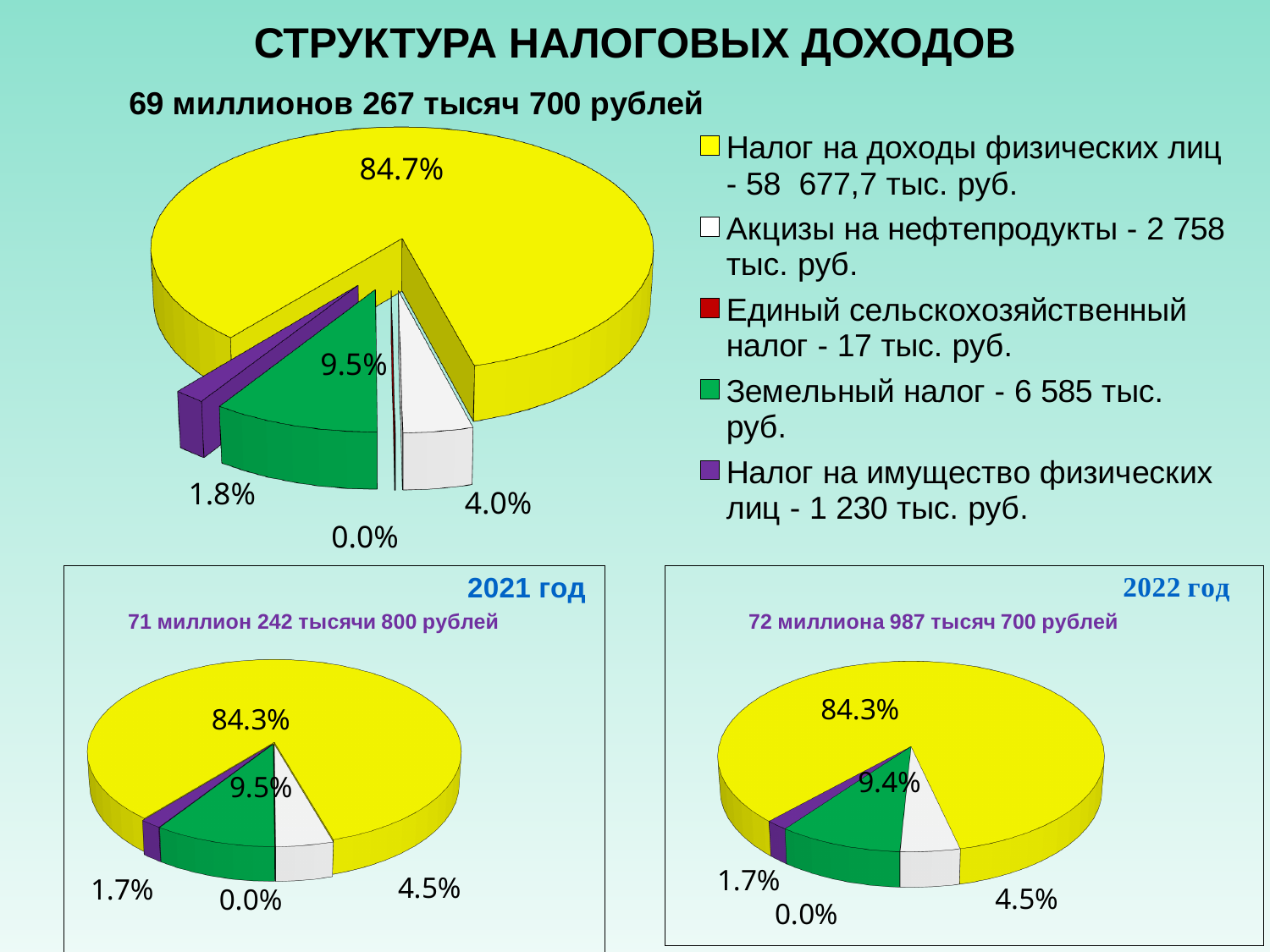
In the 2022 год pie chart, what share does the green slice have? 9.4% In the top pie chart, what share does Земельный налог have? 9.5% In the top pie chart, which category has the largest slice? Налог на доходы физических лиц How many categories does the legend of the top chart list? 5 By how many percentage points does the green slice in the 2021 год chart exceed the green slice in the 2022 год chart? 0.1 In the top pie chart, which category has the smallest slice? Единый сельскохозяйственный налог In the top pie chart, which is larger: the share of Акцизы на нефтепродукты or the share of Налог на имущество физических лиц? Акцизы на нефтепродукты What total amount is printed above the 2022 год pie chart? 72 миллиона 987 тысяч 700 рублей What kind of chart is the top chart on the slide? pie chart According to the legend of the top chart, what is the value for Акцизы на нефтепродукты? 2 758 тыс. руб. In the top pie chart, what share does Налог на доходы физических лиц have? 84.7%